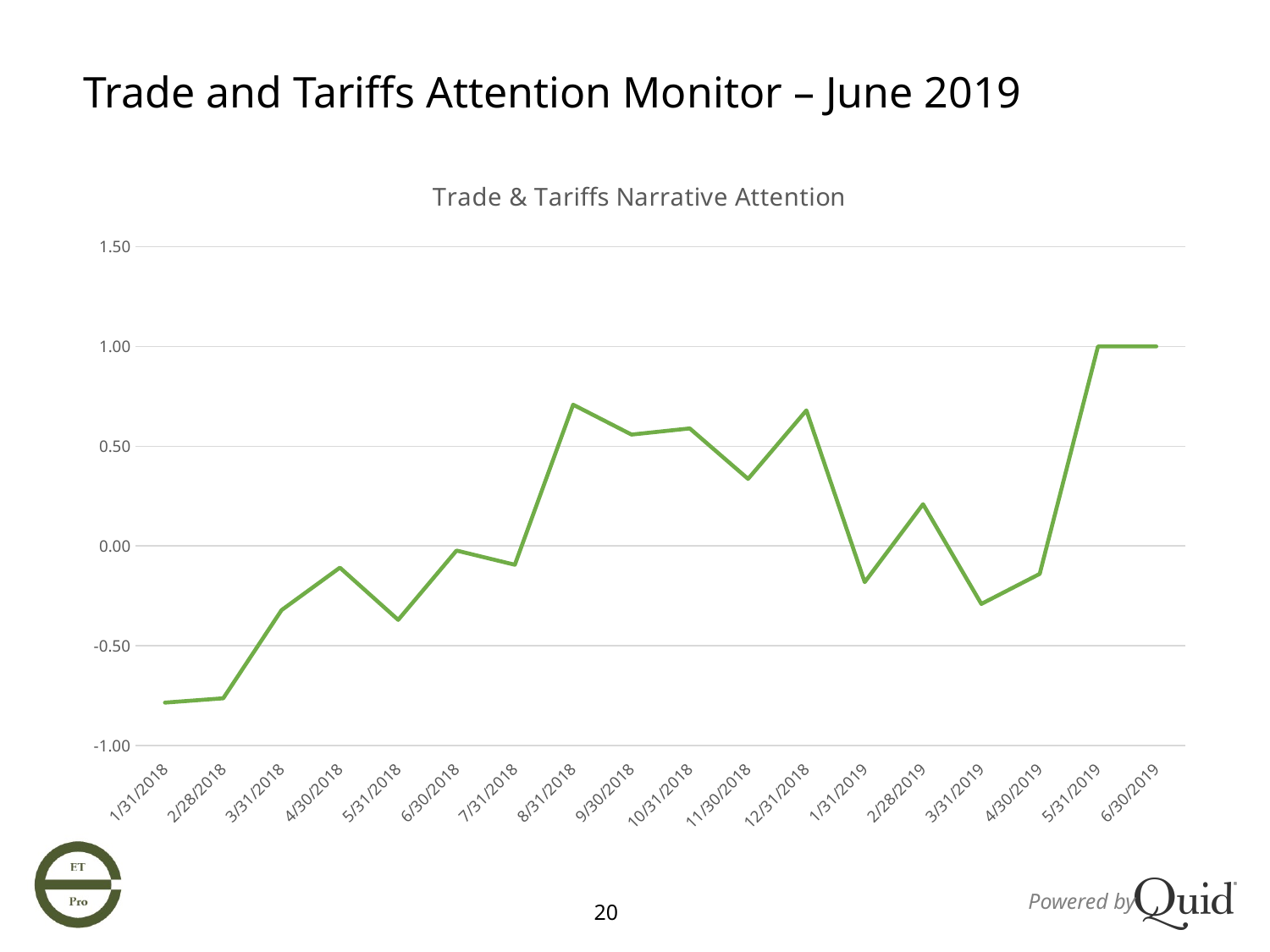
Which is larger, the value for 1/31/2019 or the value for 2/28/2019? 2/28/2019 Is the value for 3/31/2019 greater or less than 0.00? less Is the value for 11/30/2018 greater or less than 0.00? greater Overall, do the values rise or fall from 1/31/2018 to 6/30/2019? rise What is the value for 6/30/2019? 1.00 Is the value for 1/31/2018 greater or less than -0.50? less What is the title of the chart? Trade & Tariffs Narrative Attention How many dates are plotted along the x axis? 18 What kind of chart is shown on the slide? line chart Which is larger, the value for 8/31/2018 or the value for 9/30/2018? 8/31/2018